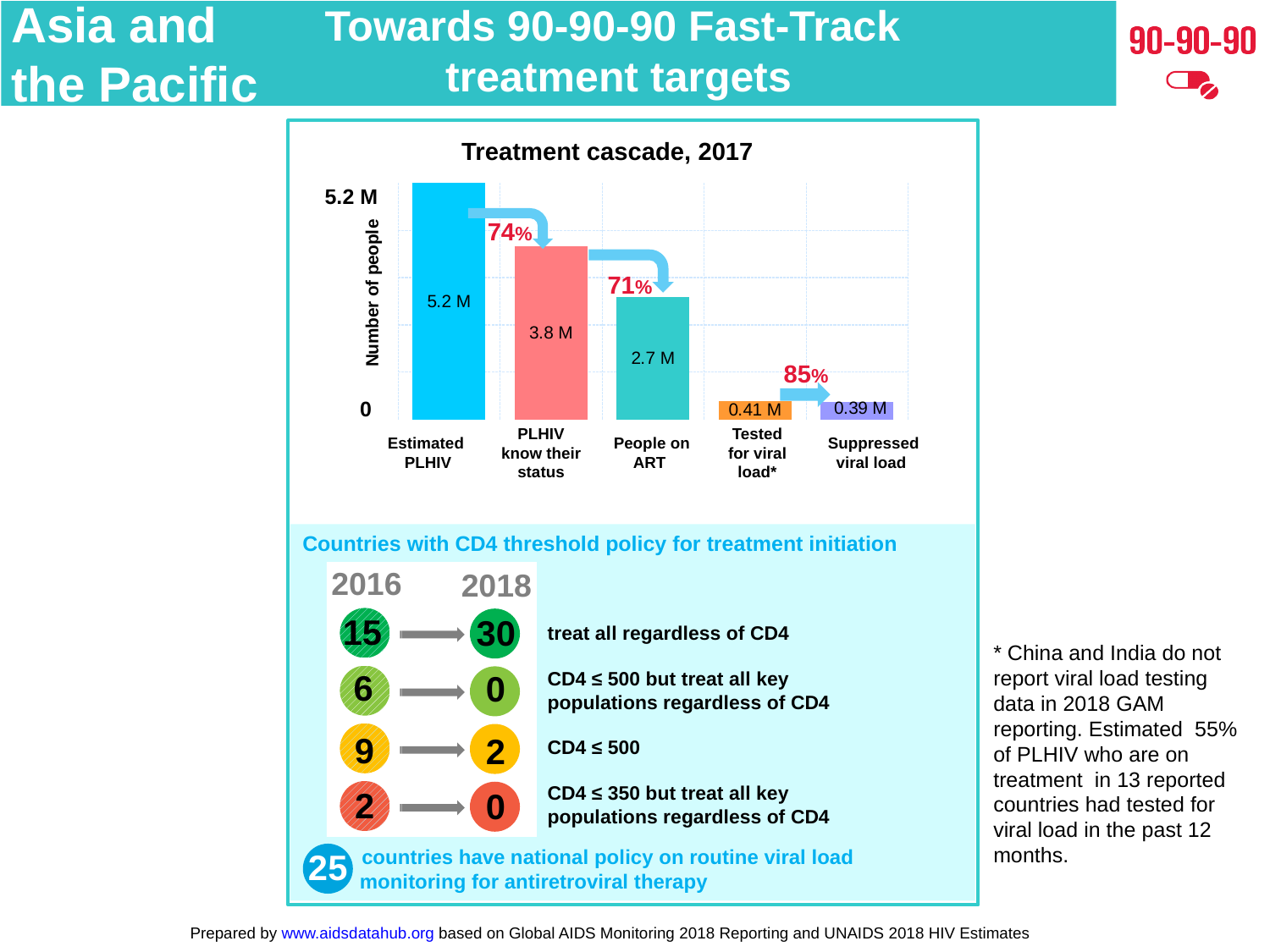
In the Treatment cascade, 2017 chart, what is the difference between Estimated PLHIV and PLHIV know their status? 1.4 M How many categories are shown in the Treatment cascade, 2017 chart? 5 In the Treatment cascade, 2017 chart, what is the value for Estimated PLHIV? 5.2 M In the Treatment cascade, 2017 chart, what is the value for Tested for viral load? 0.41 M In the Treatment cascade, 2017 chart, which category has the lowest value? Suppressed viral load In the Treatment cascade, 2017 chart, which is larger: People on ART or PLHIV know their status? PLHIV know their status In the Treatment cascade, 2017 chart, what is the value for PLHIV know their status? 3.8 M In the Treatment cascade, 2017 chart, what is the value for Suppressed viral load? 0.39 M What kind of chart is the Treatment cascade, 2017 chart? Bar chart In the Treatment cascade, 2017 chart, what percentage is shown between People on ART and PLHIV know their status? 71% In the Treatment cascade, 2017 chart, which category has the highest value? Estimated PLHIV In the Treatment cascade, 2017 chart, what is the value for People on ART? 2.7 M